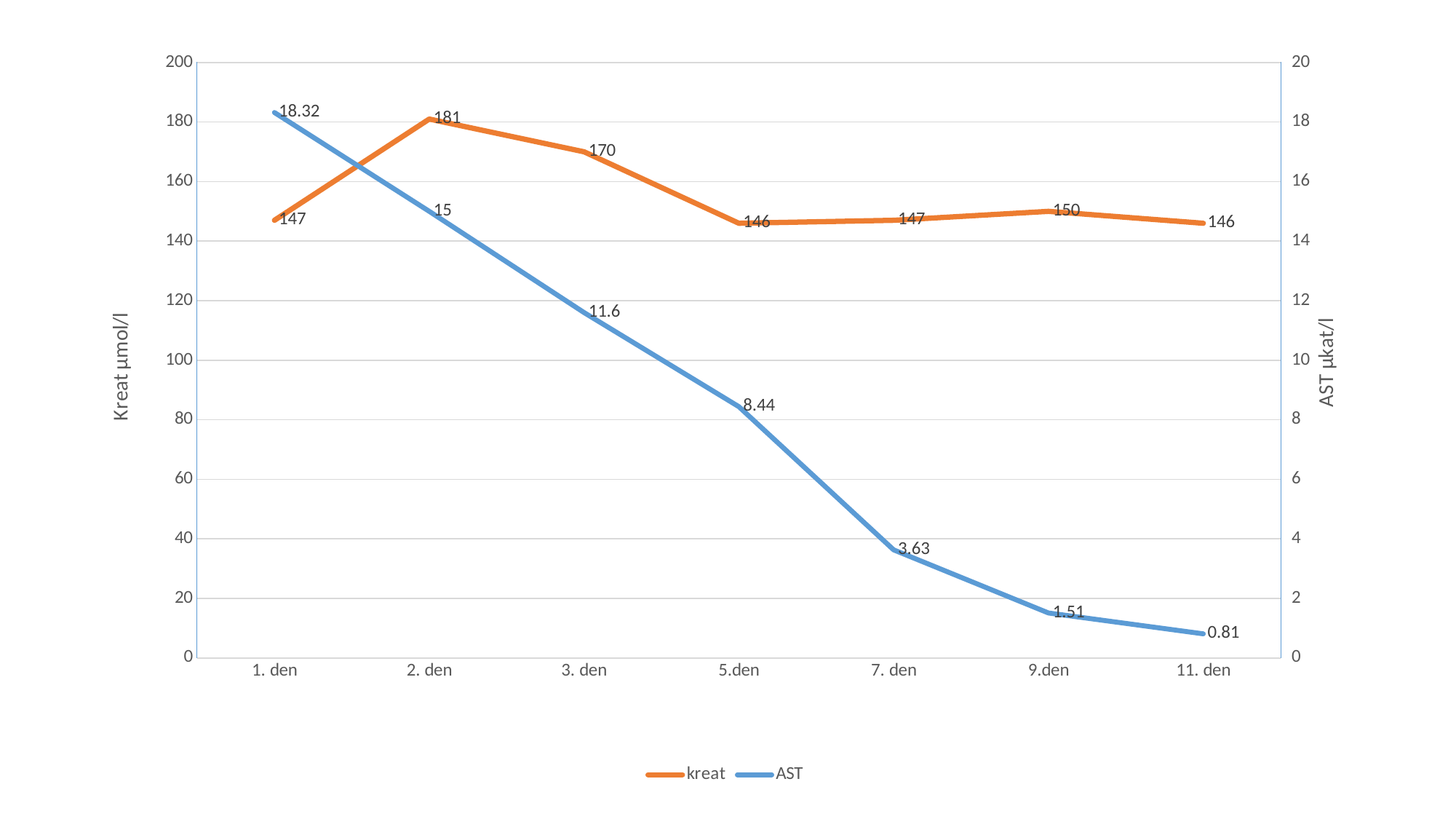
On which day is the AST value lowest? 11. den Which is larger, the kreat value on 9.den or on 11. den? 9.den What is the AST value on 5.den? 8.44 What is the difference between the AST value on 1. den and on 2. den? 3.32 What is the kreat value on 2. den? 181 What is the AST value on 11. den? 0.81 Does the AST series rise or fall from 1. den to 11. den? fall How many days are shown on the x axis? 7 What is the difference between the kreat value on 2. den and on 3. den? 11 What kind of chart is this? line chart On which day is the kreat value highest? 2. den How many series does the legend list? 2